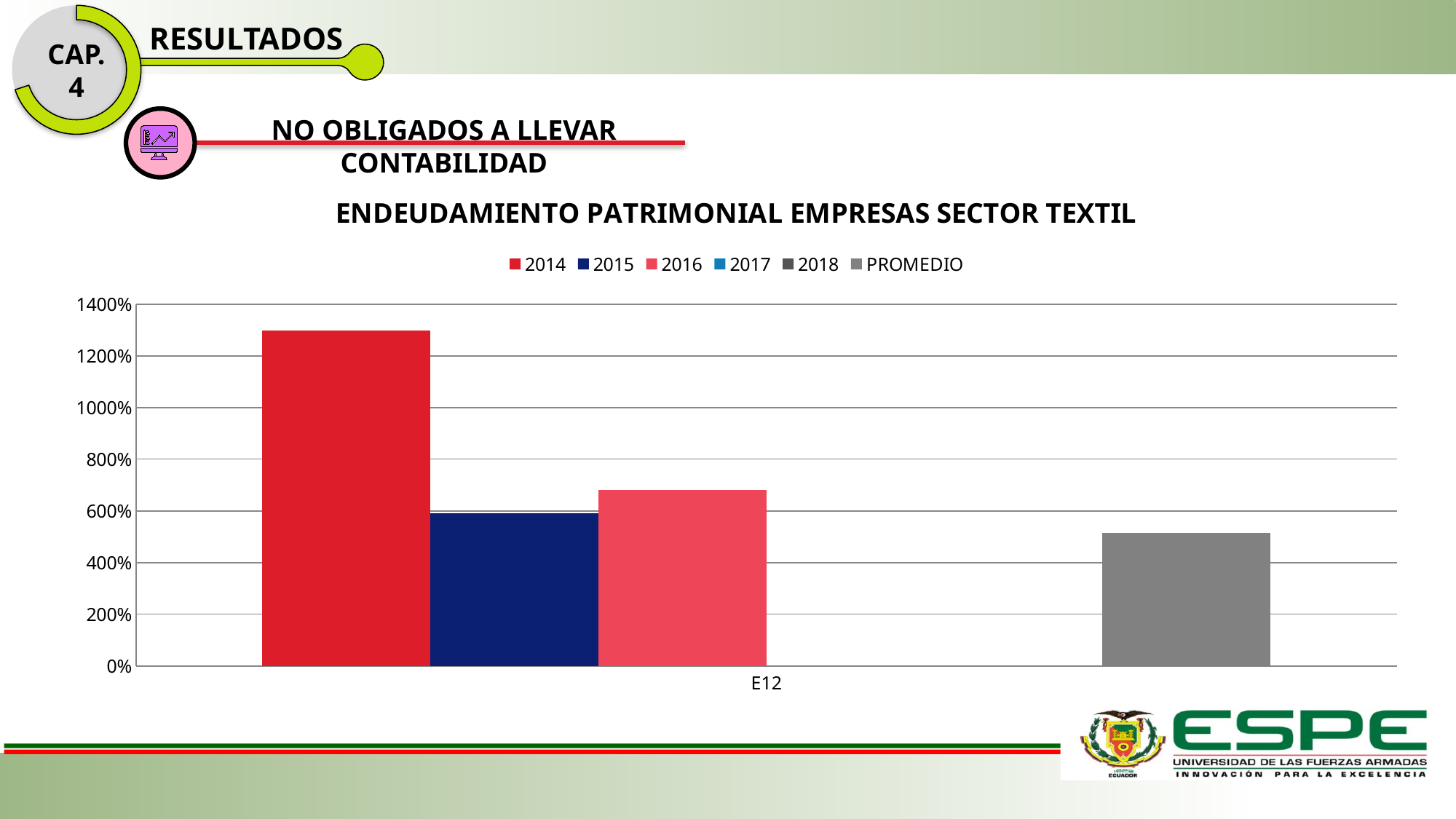
What is the label of the category on the x axis? E12 How many categories are shown on the x axis? 1 Which is larger for E12, the value for 2016 or the value for 2015? 2016 What is the title of the chart? ENDEUDAMIENTO PATRIMONIAL EMPRESAS SECTOR TEXTIL What kind of chart is shown on the slide? bar chart Is the value for PROMEDIO greater or less than 600%? less How many series does the legend list? 6 Which is larger for E12, the value for 2015 or the value for PROMEDIO? 2015 Is the value for 2015 greater or less than 400%? greater Which series has the highest bar for E12? 2014 Is the value for 2016 greater or less than 800%? less